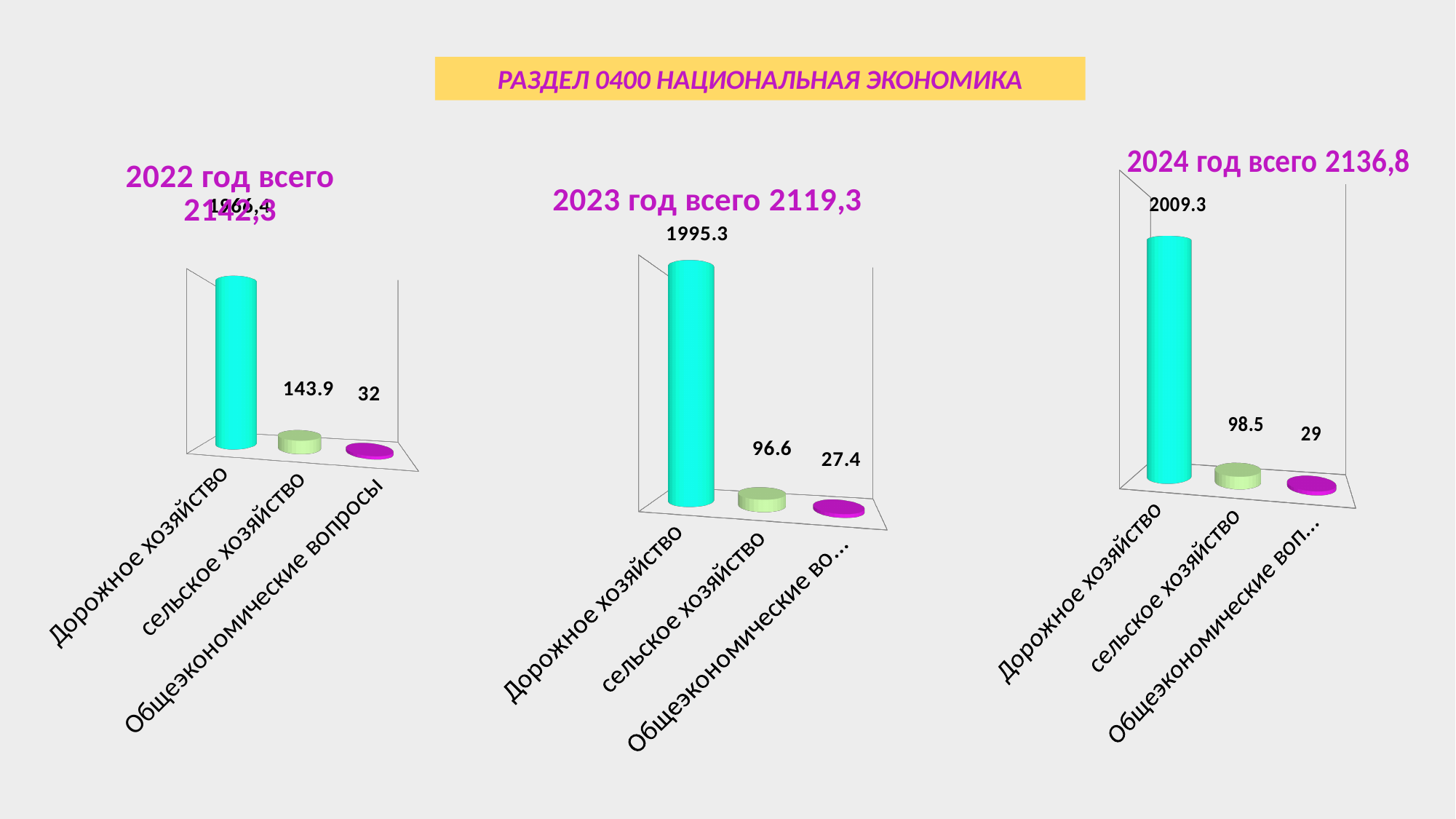
In the 2022 chart (2022 год всего 2142,3), what is the value for Общеэкономические вопросы? 32 In the 2022 chart (2022 год всего 2142,3), what is the value for сельское хозяйство? 143.9 What is the title of the chart on the right of the slide? 2024 год всего 2136,8 In the 2023 chart (2023 год всего 2119,3), which category has the lowest value? Общеэкономические вопросы What kind of chart is the 2024 chart (2024 год всего 2136,8)? Bar chart Which is larger: сельское хозяйство in the 2022 chart or сельское хозяйство in the 2024 chart? 2022 chart In the 2024 chart (2024 год всего 2136,8), what is the value for сельское хозяйство? 98.5 In the 2023 chart (2023 год всего 2119,3), what is the difference between сельское хозяйство and Общеэкономические вопросы? 69.2 In the 2023 chart (2023 год всего 2119,3), what is the value for Дорожное хозяйство? 1995.3 In the 2024 chart (2024 год всего 2136,8), what is the difference between Дорожное хозяйство and сельское хозяйство? 1910.8 In the 2024 chart (2024 год всего 2136,8), which category has the highest value? Дорожное хозяйство How many categories are shown in the 2023 chart (2023 год всего 2119,3)? 3